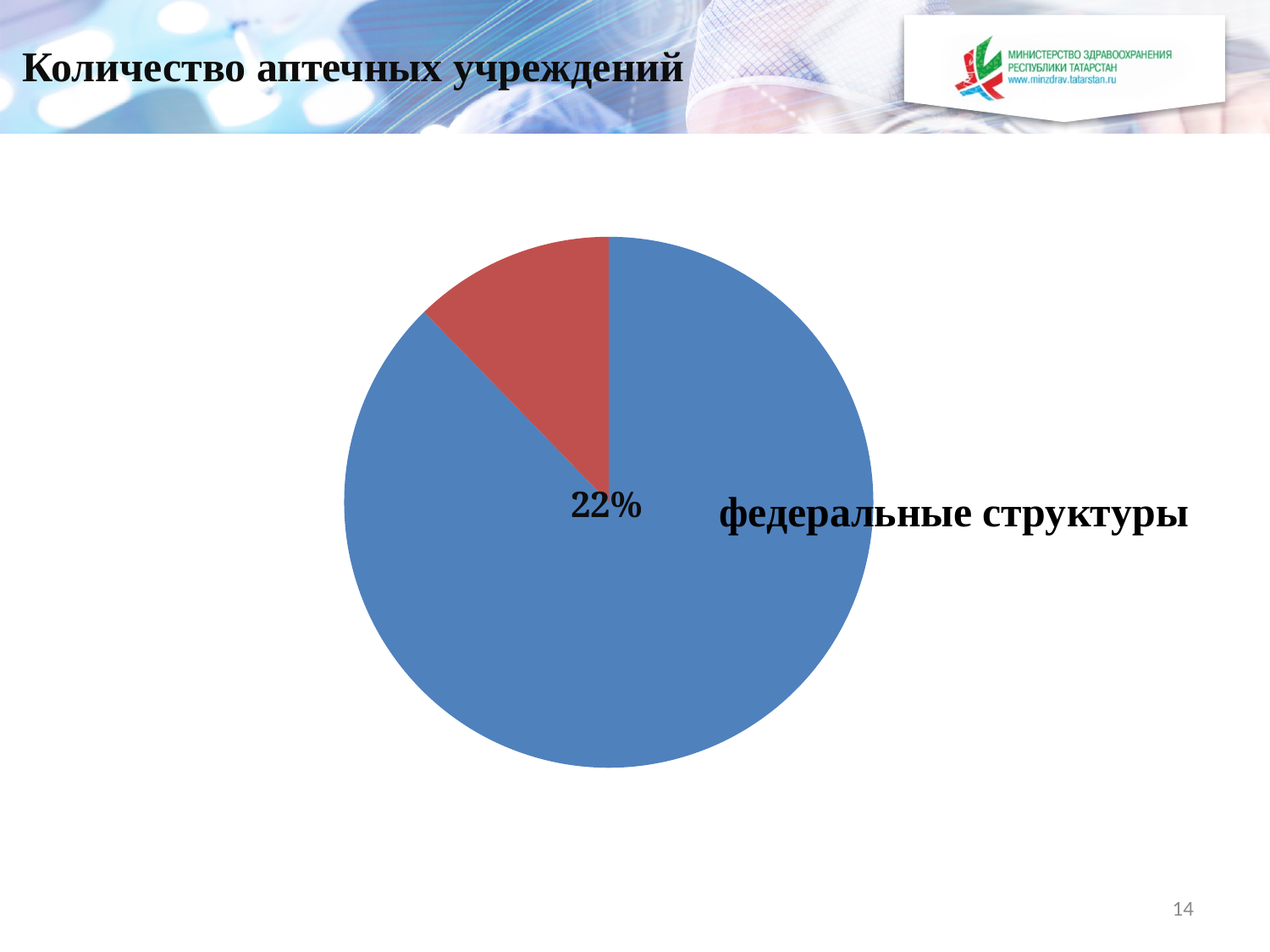
How many slices does the pie chart have? 2 What is the title of the slide containing the pie chart? Количество аптечных учреждений Does the red slice take up more or less than half of the pie? less What percentage value is printed on the pie chart? 22% What kind of chart is shown on the slide? pie chart Which slice is larger, the blue slice or the red slice? the blue slice What colour is the largest slice of the pie chart? blue